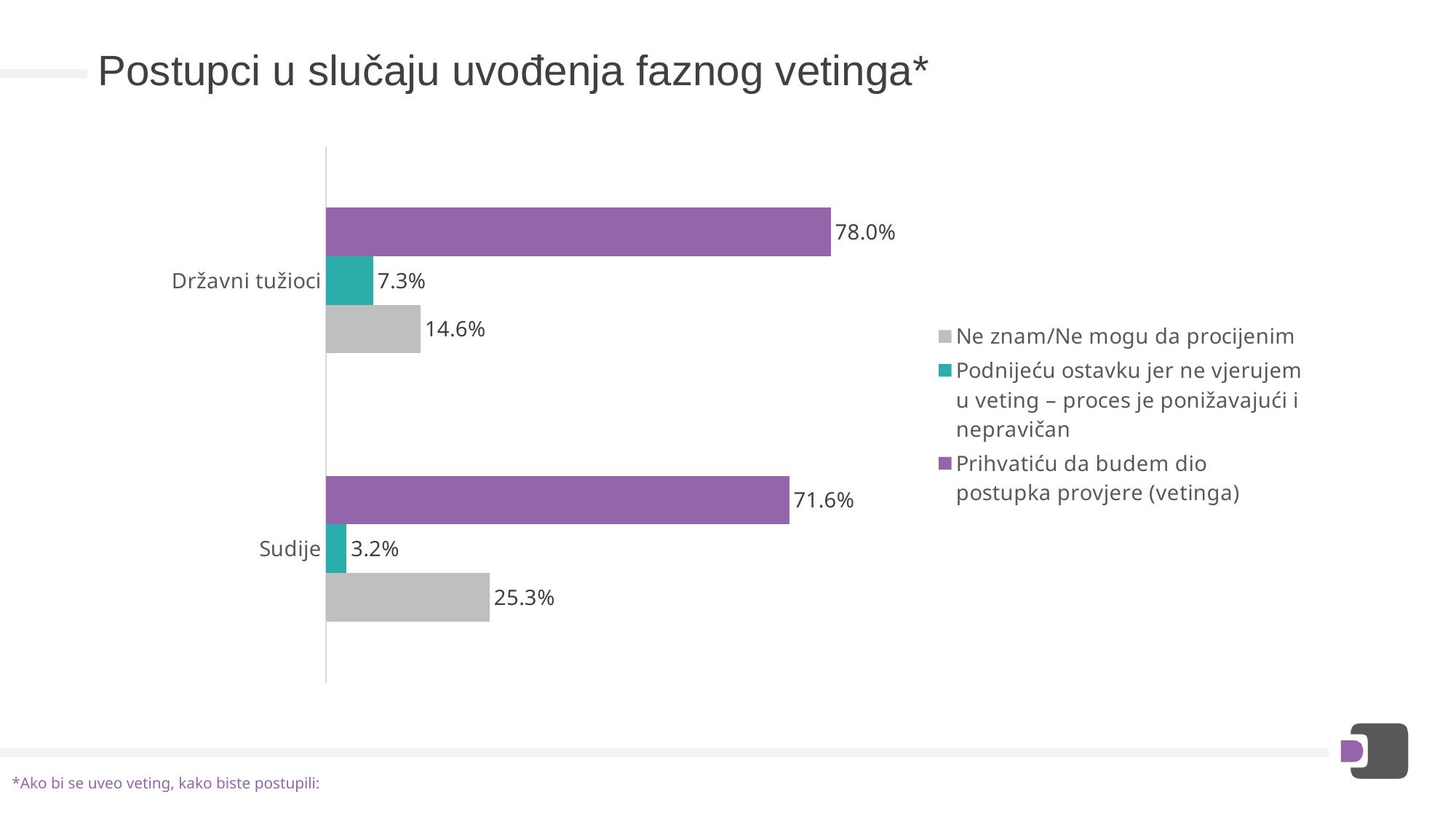
What is the value for Državni tužioci in the "Ne znam/Ne mogu da procijenim" series? 14.6% What is the difference between the "Prihvatiću da budem dio postupka provjere (vetinga)" values for Državni tužioci and Sudije? 6.4% What type of chart is shown on the slide? Bar chart Which series has the lowest value for Sudije? Podnijeću ostavku jer ne vjerujem u veting – proces je ponižavajući i nepravičan Which category has the higher value for "Prihvatiću da budem dio postupka provjere (vetinga)"? Državni tužioci What is the difference between the "Ne znam/Ne mogu da procijenim" values for Sudije and Državni tužioci? 10.7% Which category has the lower value for "Ne znam/Ne mogu da procijenim"? Državni tužioci How many series does the legend list? 3 What percentage of Državni tužioci said "Prihvatiću da budem dio postupka provjere (vetinga)"? 78.0% What is the value for Sudije in the series "Podnijeću ostavku jer ne vjerujem u veting – proces je ponižavajući i nepravičan"? 3.2% What percentage of Sudije answered "Ne znam/Ne mogu da procijenim"? 25.3% How many categories are shown on the chart? 2